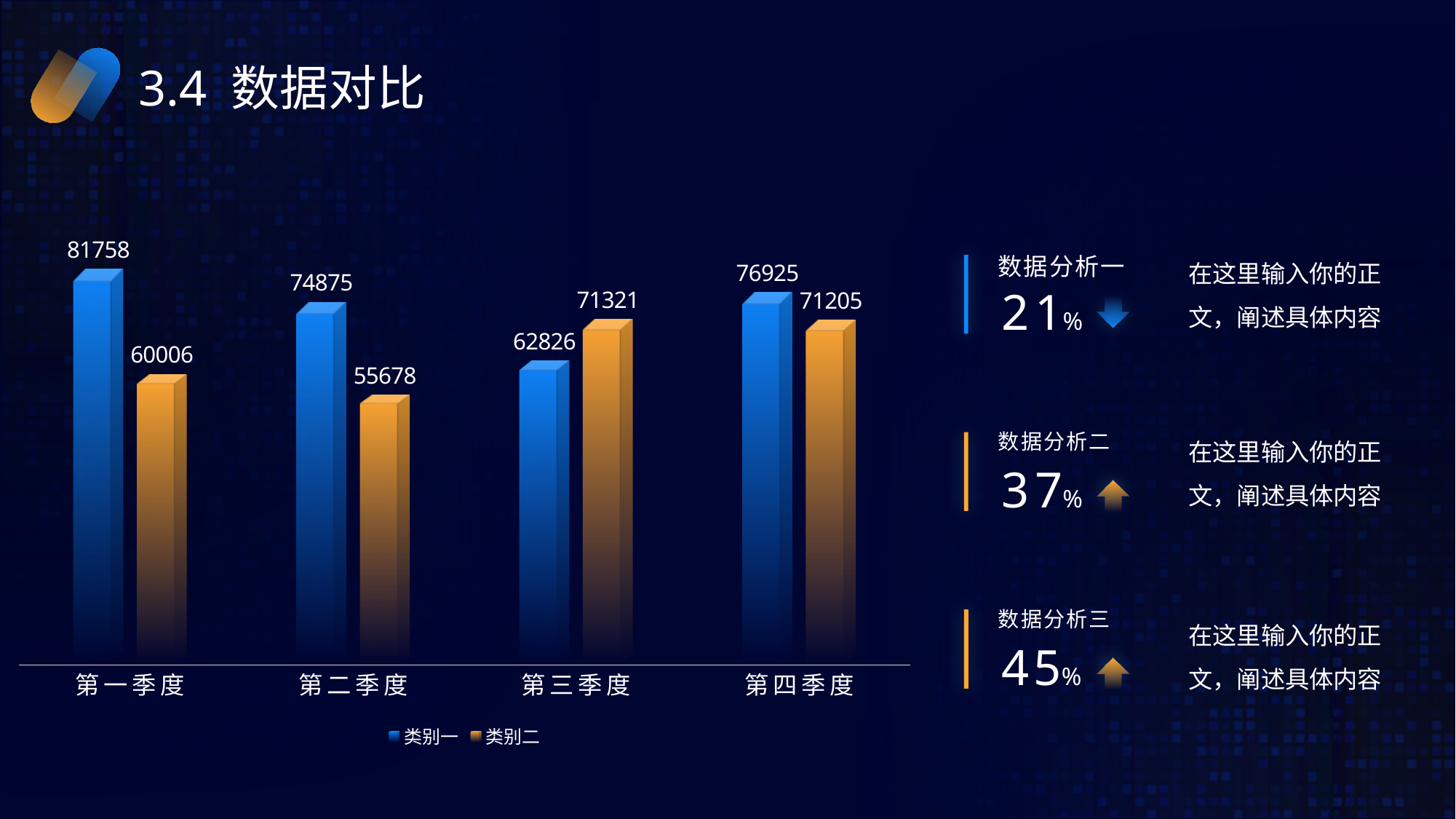
What is the value of 类别二 for 第四季度? 71205 What is the value of 类别一 for 第一季度? 81758 In which quarter is 类别一 highest? 第一季度 What kind of chart is shown on the slide? Bar chart In which quarter is 类别二 lowest? 第二季度 What is the difference between 类别一 and 类别二 in 第一季度? 21752 In 第三季度, which is larger, 类别一 or 类别二? 类别二 How many quarters are shown on the x axis of the chart? 4 What is the value of 类别二 for 第二季度? 55678 What is the difference between 类别二 and 类别一 in 第三季度? 8495 How many series does the chart legend list? 2 In which quarter is 类别一 lowest? 第三季度